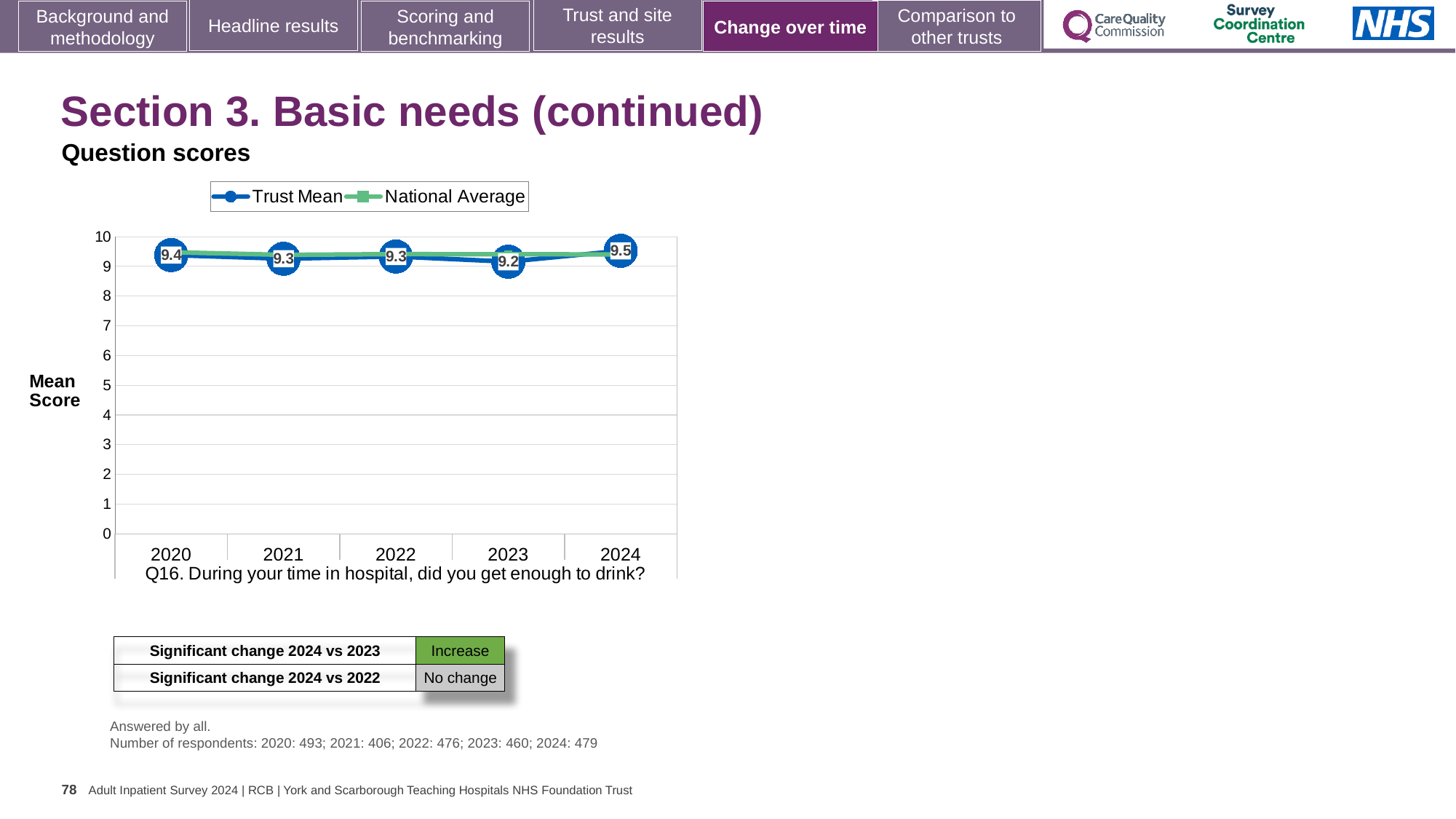
Did the Trust Mean score rise or fall from 2023 to 2024? Rise Is the National Average value for 2022 greater or less than 8? greater How many years are shown on the x axis of the chart? 5 What kind of chart is shown on the slide? Line chart How many series does the chart legend list? 2 What is the Trust Mean score for 2023? 9.2 What is the Trust Mean score for 2020? 9.4 In which year is the Trust Mean score lowest? 2023 Which year has the larger Trust Mean score, 2020 or 2023? 2020 What is the difference between the Trust Mean scores for 2024 and 2023? 0.3 What is the Trust Mean score for 2024? 9.5 In which year is the Trust Mean score highest? 2024